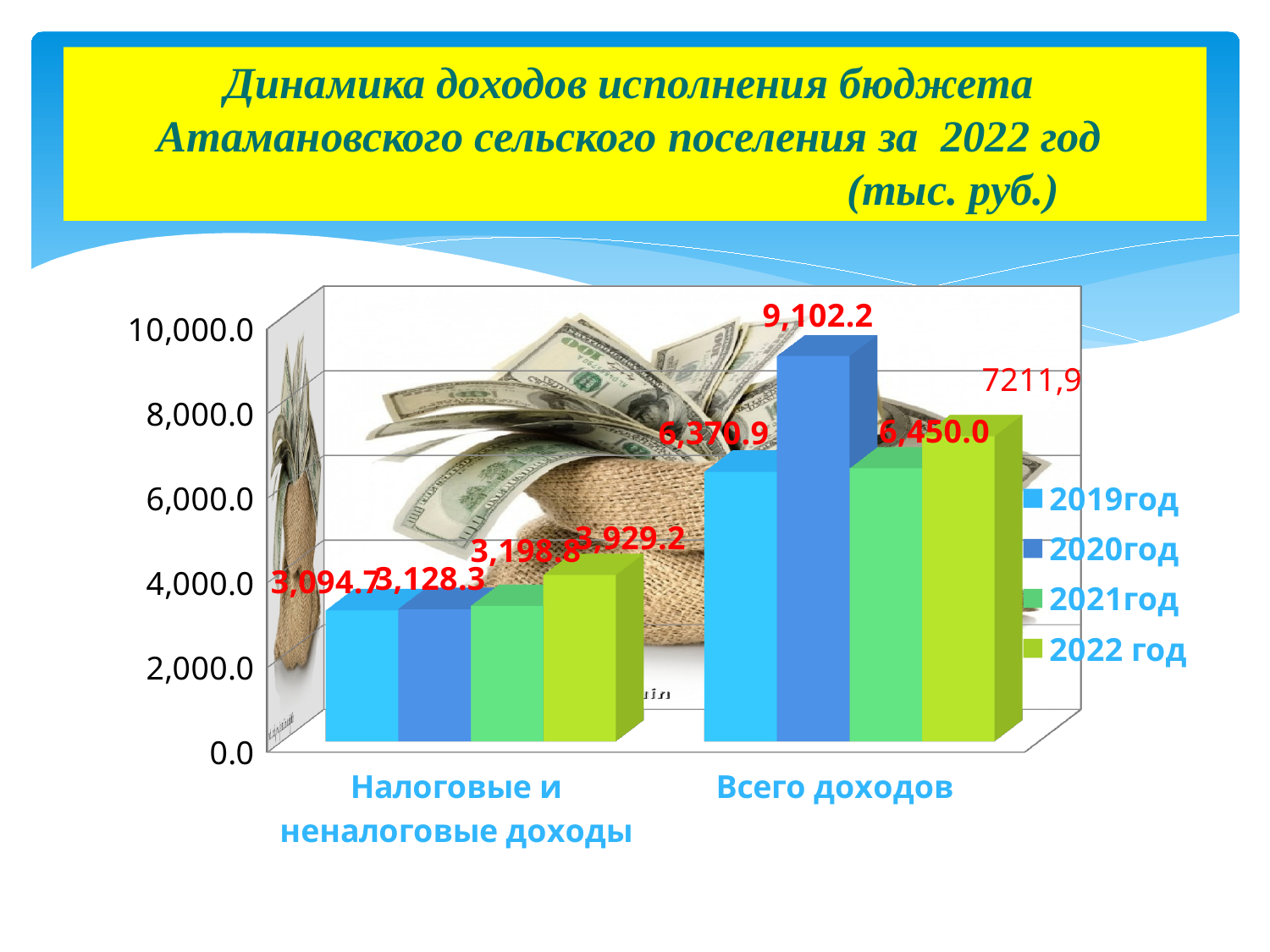
Is the value for 2020год in the Всего доходов category greater or less than 8,000.0? greater How many series does the legend list? 4 What is the value for 2022 год in the Налоговые и неналоговые доходы category? 3,929.2 What is the value for 2020год in the Всего доходов category? 9,102.2 What is the value for 2019год in the Налоговые и неналоговые доходы category? 3,094.7 Which is larger in the Всего доходов category: the 2019год value or the 2021год value? 2021год What is the difference between the 2022 год and 2021год values in the Налоговые и неналоговые доходы category? 730.4 How many categories are shown on the x axis? 2 What is the value for 2021год in the Всего доходов category? 6,450.0 Which year has the lowest value in the Налоговые и неналоговые доходы category? 2019год Which year has the highest value in the Всего доходов category? 2020год What kind of chart is shown on the slide? bar chart